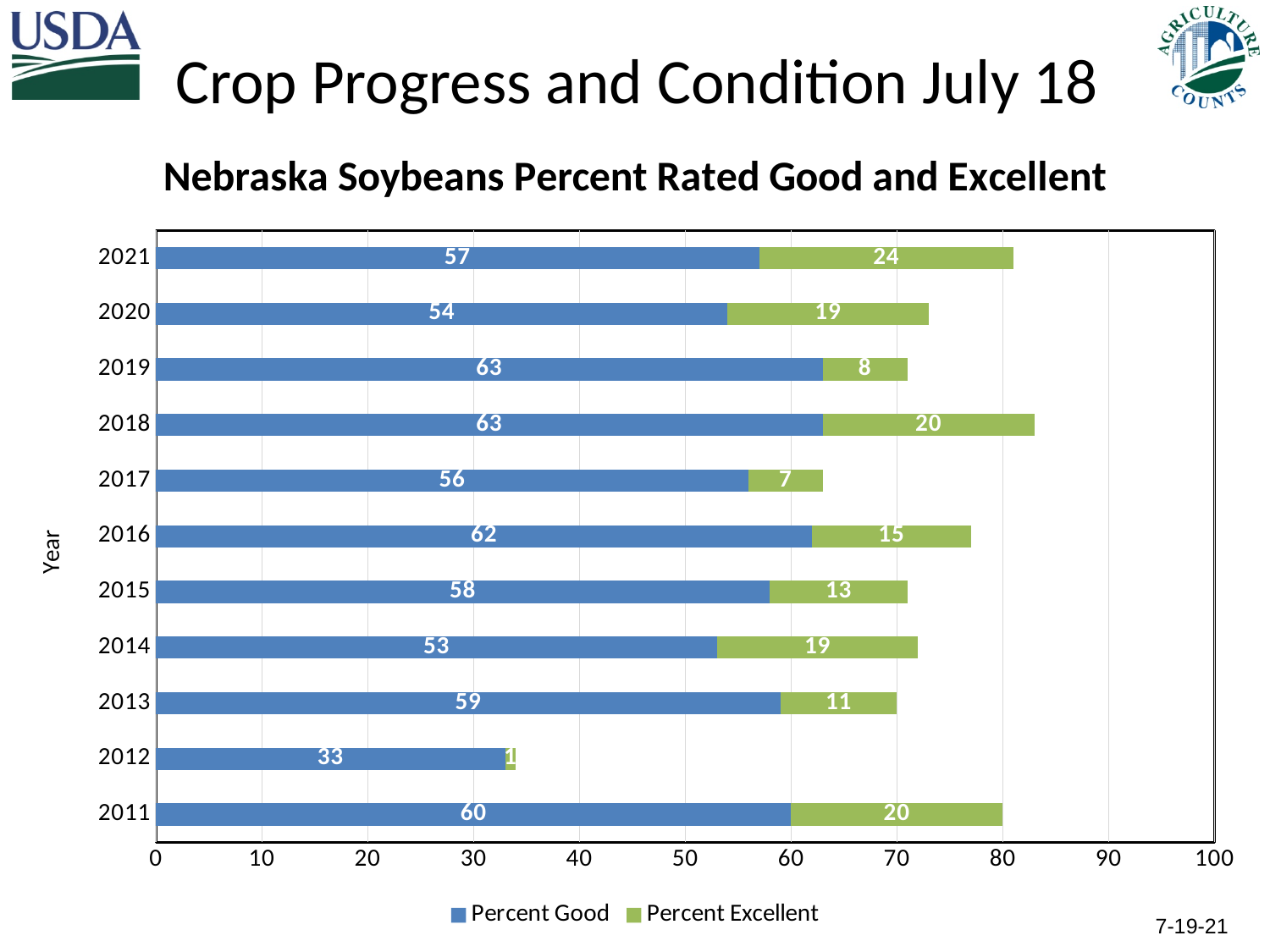
How many series does the legend list? 2 What is the Percent Good value for 2021? 57 Is the total of the stacked bar for 2012 greater or less than 40? less What is the total of the stacked bar for 2018? 83 Which year has the lowest Percent Good value? 2012 Which is larger, the Percent Excellent value for 2017 or for 2016? 2016 Which year has the highest Percent Excellent value? 2021 What is the difference between the Percent Good values for 2011 and 2012? 27 What kind of chart is shown on the slide? Stacked bar chart What is the Percent Excellent value for 2019? 8 What is the title of the chart? Nebraska Soybeans Percent Rated Good and Excellent How many years are shown on the chart? 11